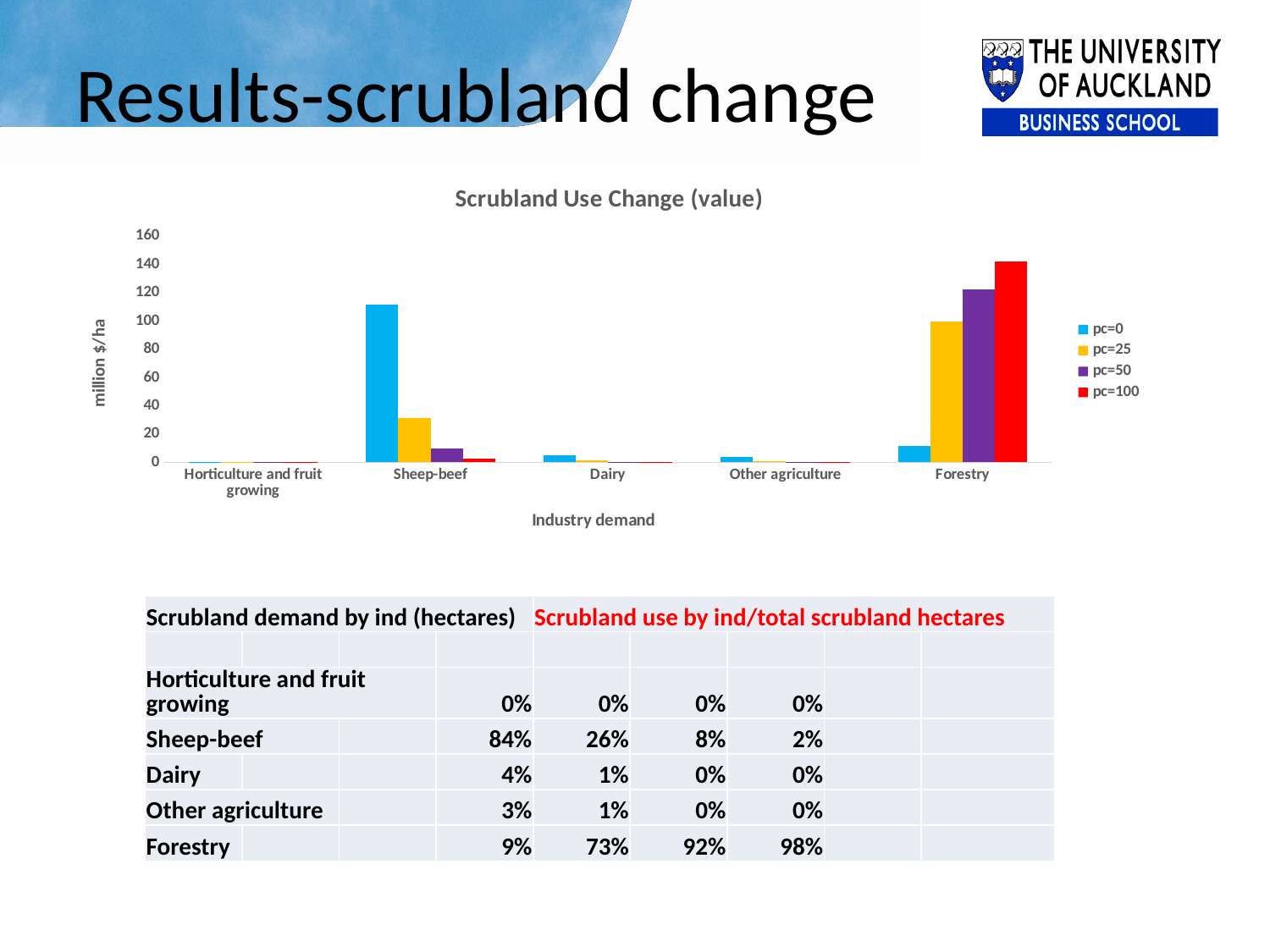
Which industry has the highest pc=0 bar in the chart? Sheep-beef For Forestry, do the bars rise or fall going from pc=0 to pc=100? rise What kind of chart is shown on the slide? bar chart Is the pc=100 value for Forestry greater or less than 120? greater Which industry has the highest pc=100 bar in the chart? Forestry What is the y-axis label of the chart? million $/ha Is the pc=0 value for Sheep-beef greater or less than 100? greater Is the pc=50 value for Forestry greater or less than 100? greater How many series does the chart legend list? 4 Which is larger: the pc=0 value for Sheep-beef or the pc=100 value for Forestry? pc=100 value for Forestry How many industry categories are shown on the x axis of the chart? 5